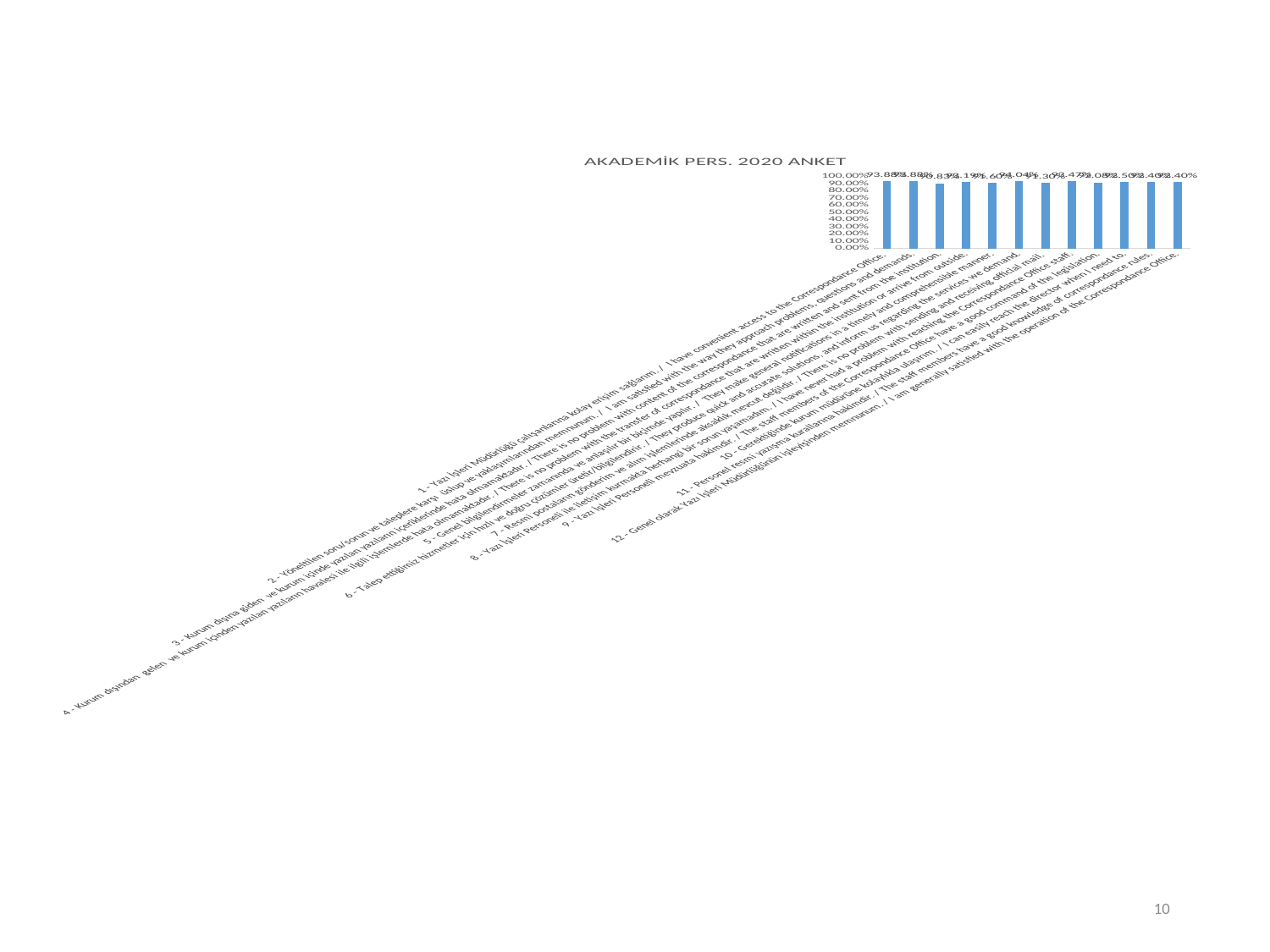
Is the value for category 1 ("I have convenient access to the Correspondence Office") greater or less than 80%? greater Is the value for category 12 ("I am generally satisfied with the operation of the Correspondence Office") greater or less than 50%? greater Is the value for category 6 greater or less than 70%? greater What kind of chart is shown on the slide? bar chart What is the highest value shown on the vertical axis? 100.00% How many bars (categories) does the chart show? 12 What is the title of the chart? AKADEMİK PERS. 2020 ANKET